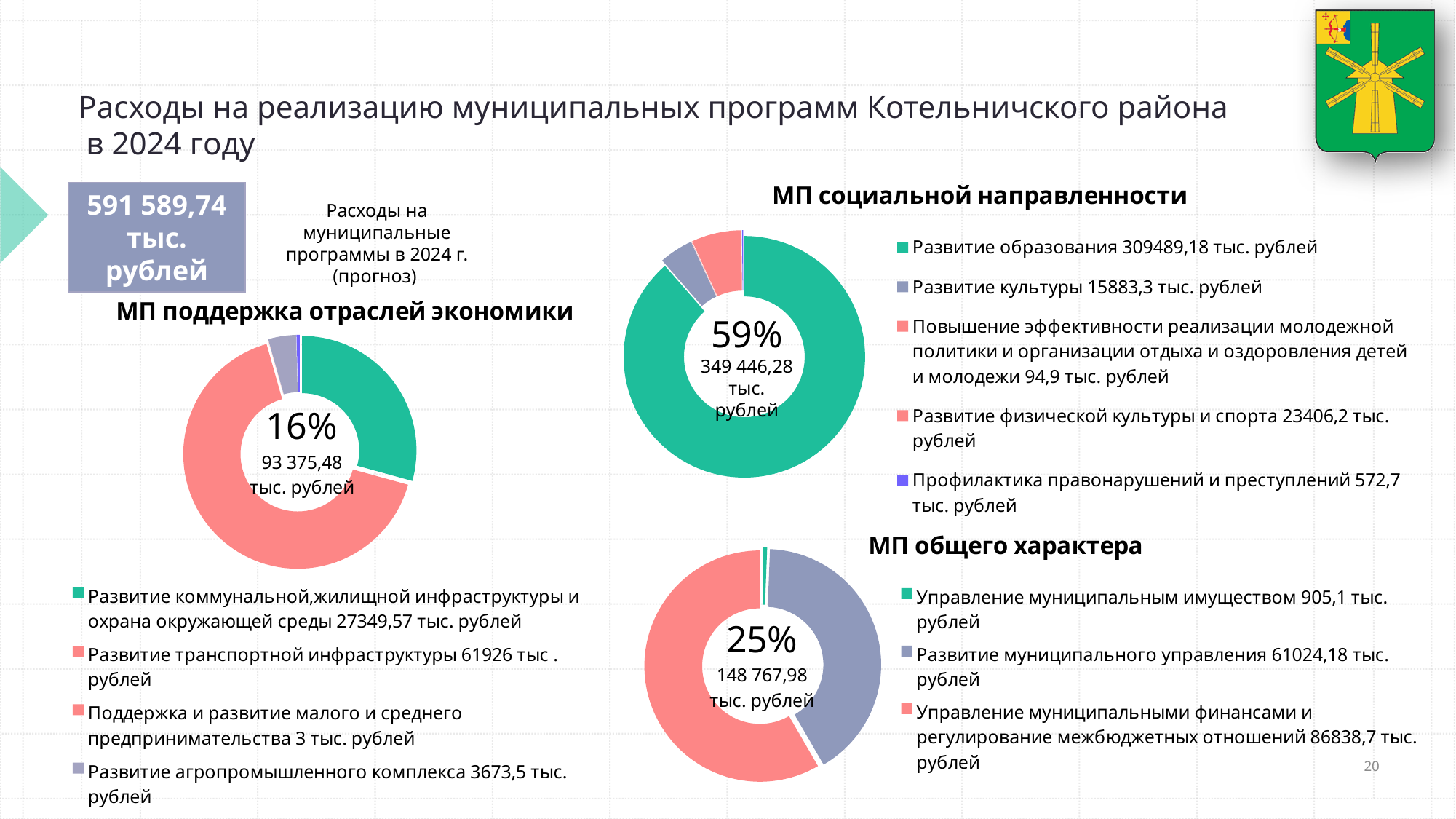
On the chart titled «МП общего характера», what value is shown for «Управление муниципальным имуществом»? 905,1 тыс. рублей On the chart titled «МП поддержка отраслей экономики», which category has the smallest value? Поддержка и развитие малого и среднего предпринимательства On the chart titled «МП поддержка отраслей экономики», how many categories does the legend list? 4 On the chart titled «МП поддержка отраслей экономики», what value is shown for «Развитие транспортной инфраструктуры»? 61926 тыс. рублей On the chart titled «МП социальной направленности», what total amount is printed in the centre of the donut? 349 446,28 тыс. рублей On the chart titled «МП социальной направленности», how many categories does the legend list? 5 On the chart titled «МП общего характера», what is the difference between «Управление муниципальными финансами и регулирование межбюджетных отношений» and «Развитие муниципального управления»? 25814,52 тыс. рублей What kind of chart is used for «МП общего характера»? Donut (pie) chart On the chart titled «МП общего характера», which is larger: «Развитие муниципального управления» or «Управление муниципальными финансами и регулирование межбюджетных отношений»? Управление муниципальными финансами и регулирование межбюджетных отношений On the chart titled «МП поддержка отраслей экономики», what percentage is printed in the centre of the donut? 16% On the chart titled «МП социальной направленности», what value is shown for «Развитие культуры»? 15883,3 тыс. рублей On the chart titled «МП социальной направленности», which category has the largest value? Развитие образования